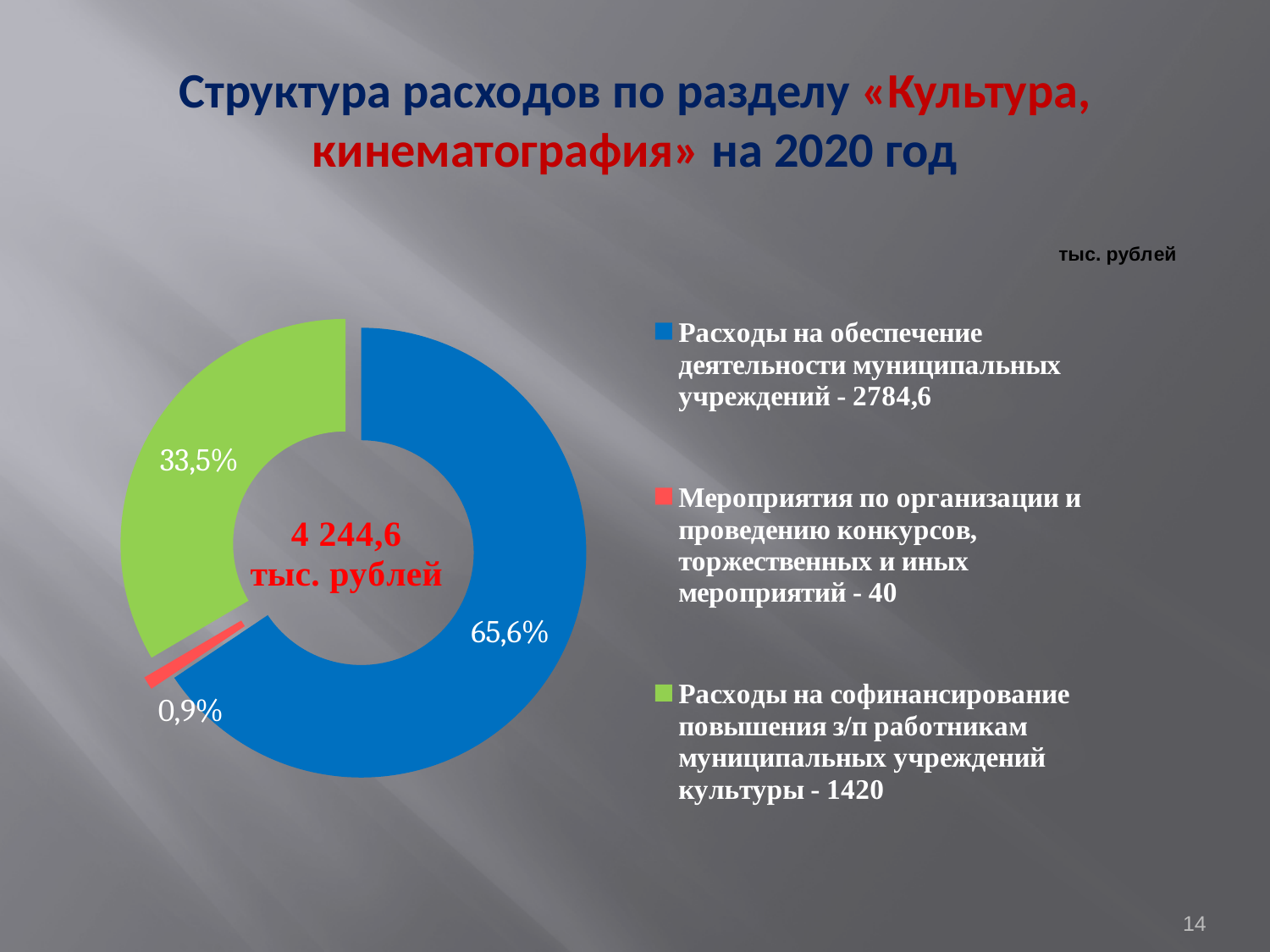
How many slices does the chart have? 3 What kind of chart is shown on the slide? Doughnut (pie) chart Which slice is larger: the blue one or the green one? The blue one How many entries does the legend list? 3 What is the difference between the value for «Расходы на обеспечение деятельности муниципальных учреждений» (2784,6) and the value for «Расходы на софинансирование повышения з/п работникам муниципальных учреждений культуры» (1420)? 1364,6 What is the total amount shown in the centre of the chart? 4 244,6 тыс. рублей What share of the chart is the slice for «Расходы на обеспечение деятельности муниципальных учреждений»? 65,6% Which category has the largest slice in the chart? Расходы на обеспечение деятельности муниципальных учреждений Which category has the smallest slice in the chart? Мероприятия по организации и проведению конкурсов, торжественных и иных мероприятий What share of the chart is the slice for «Мероприятия по организации и проведению конкурсов, торжественных и иных мероприятий»? 0,9% What value (тыс. рублей) is given in the legend for «Расходы на софинансирование повышения з/п работникам муниципальных учреждений культуры»? 1420 What share of the chart is the slice for «Расходы на софинансирование повышения з/п работникам муниципальных учреждений культуры»? 33,5%